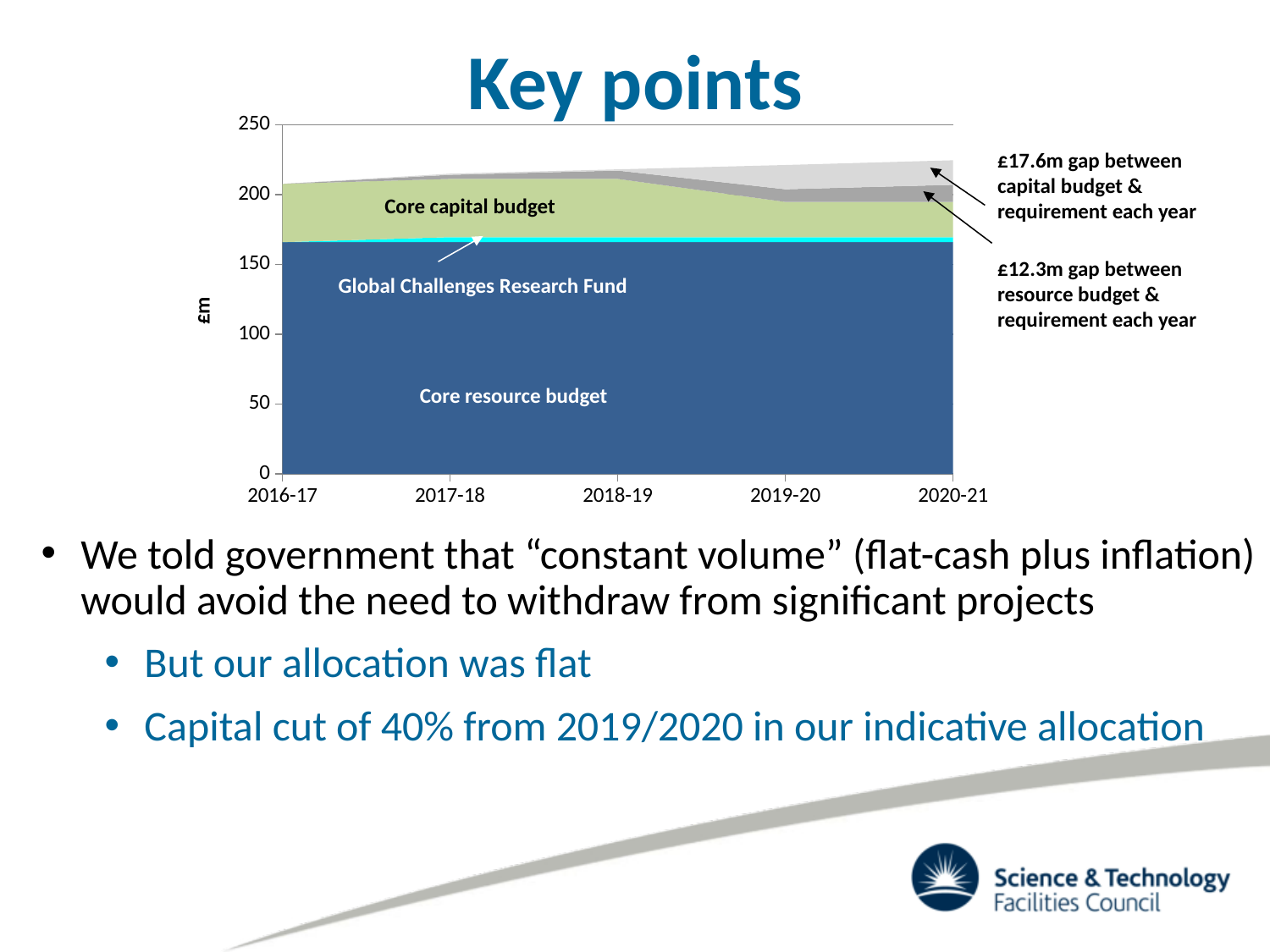
According to the annotation, what is the gap between the resource budget and requirement each year? £12.3m Does the core capital budget rise or fall between 2018-19 and 2019-20? fall What kind of chart is shown on the slide? Stacked area chart How many financial years are shown on the x axis of the chart? 5 Is the core resource budget in 2016-17 greater or less than 150? greater Which budget area is plotted at the bottom of the stacked chart? Core resource budget How many named budget areas are labelled inside the chart? 3 Is the core resource budget in 2020-21 greater or less than 200? less According to the annotation, what is the gap between the capital budget and requirement each year? £17.6m Does the core resource budget rise, fall or stay flat across the years shown? stay flat Is the top of the core capital budget area in 2016-17 greater or less than 200? greater What is the label on the y axis of the chart? £m